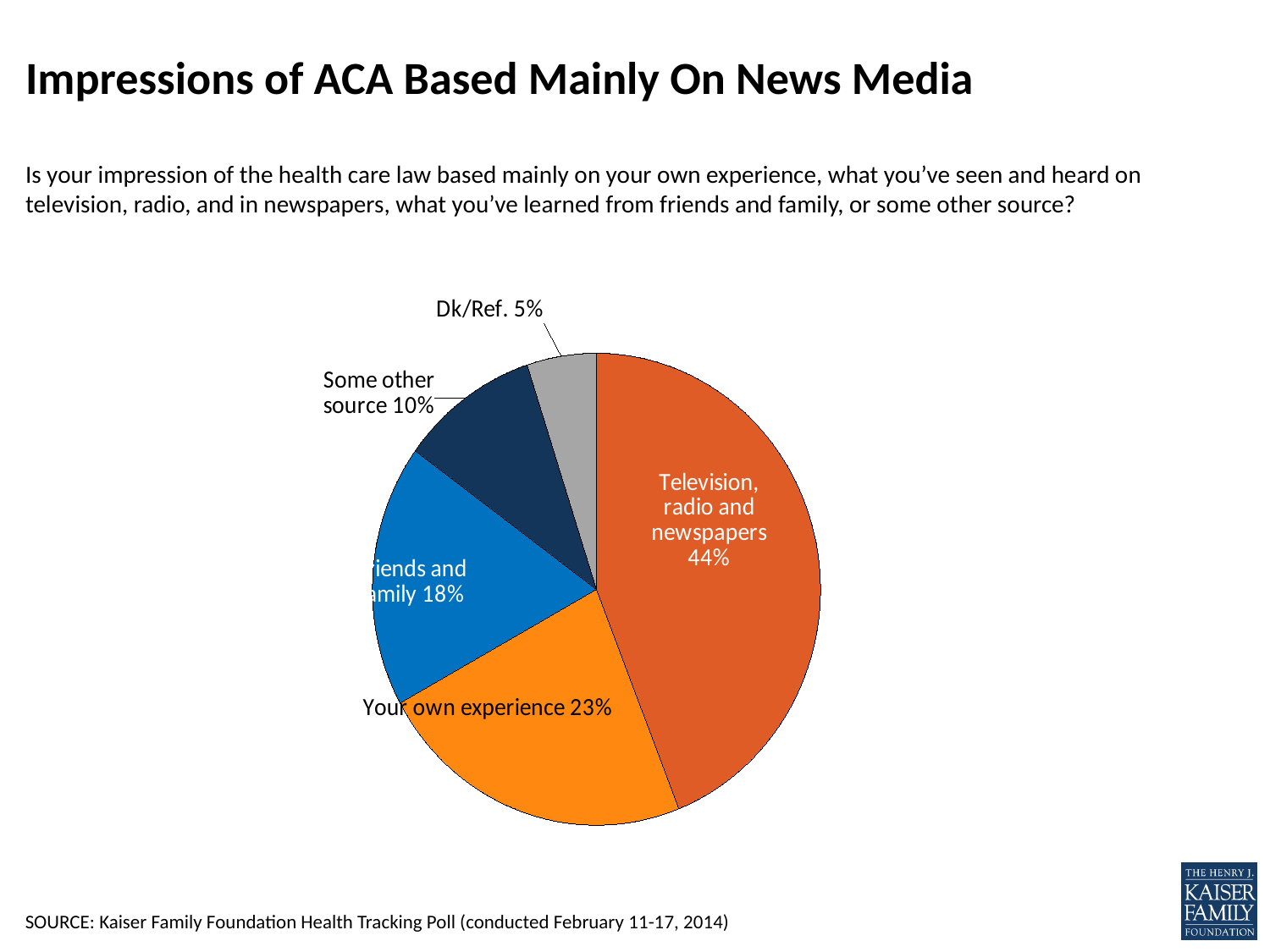
Which category has the smallest share of the pie? Dk/Ref. What share of respondents said their impression is based mainly on television, radio and newspapers? 44% What is the title of the slide? Impressions of ACA Based Mainly On News Media How many percentage points larger is the share for television, radio and newspapers than the share for your own experience? 21 What share of respondents said their impression is based mainly on friends and family? 18% What share of respondents said their impression is based mainly on their own experience? 23% Which source has the largest share of the pie? Television, radio and newspapers How many slices does the pie chart have? 5 Which is larger: the share for friends and family or the share for some other source? Friends and family What kind of chart is shown on the slide? pie chart What share of respondents answered Dk/Ref.? 5% What share of respondents said their impression is based mainly on some other source? 10%